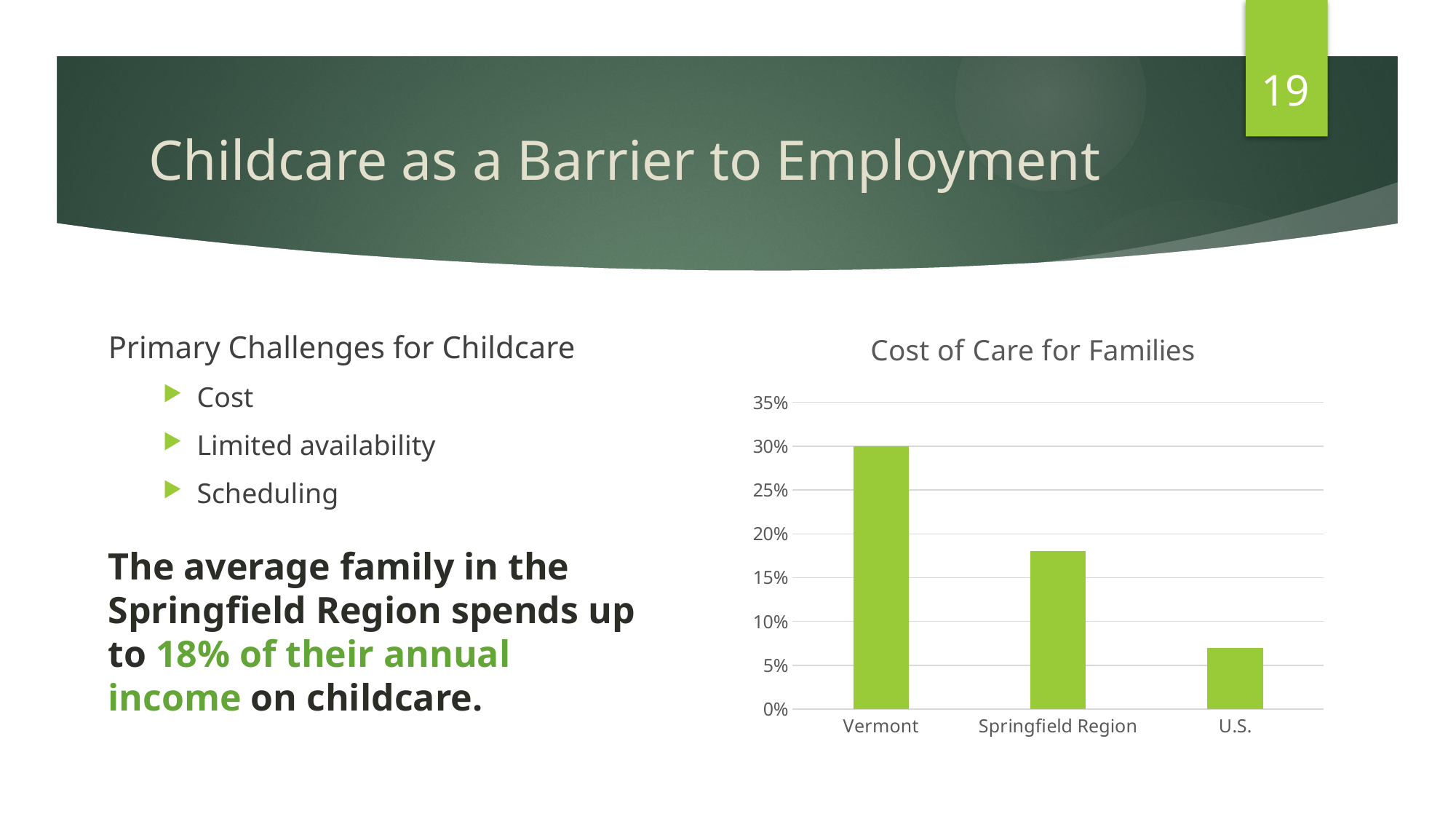
Is the value for Springfield Region greater or less than 20%? less What kind of chart is shown on the slide? bar chart Is the value for Springfield Region greater or less than 15%? greater Which category has the highest value in the chart? Vermont Which is larger, the value for Springfield Region or the value for U.S.? Springfield Region Which category has the lowest value in the chart? U.S. Is the value for U.S. greater or less than 10%? less What is the title of the chart? Cost of Care for Families Which is larger, the value for Vermont or the value for Springfield Region? Vermont How many categories are shown on the x axis of the chart? 3 Do the bar values rise or fall from left to right across the x axis? fall What is the value for Vermont in the chart? 30%